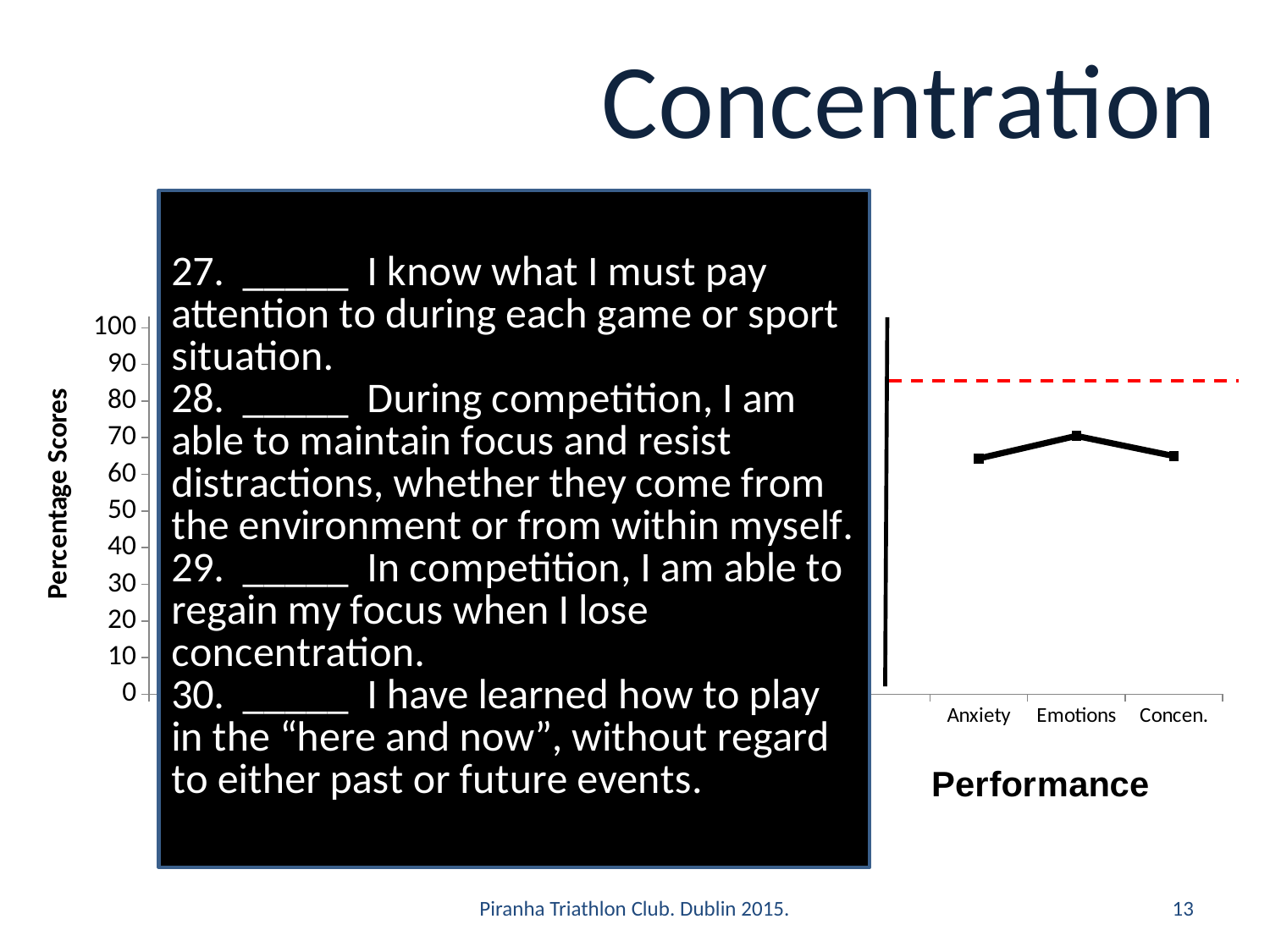
Among the visible categories Anxiety, Emotions and Concen., which has the highest value? Emotions Is the value for Emotions greater or less than 80? less Is the value for Anxiety greater or less than 50? greater Does the line rise or fall from Anxiety to Emotions? rises Is the value for Anxiety greater or less than 70? less What is the title of the vertical axis? Percentage Scores What label appears below the category axis of the chart? Performance Which is larger, the value for Emotions or the value for Anxiety? Emotions What kind of chart is shown on the slide? line chart Does the line rise or fall from Emotions to Concen.? falls